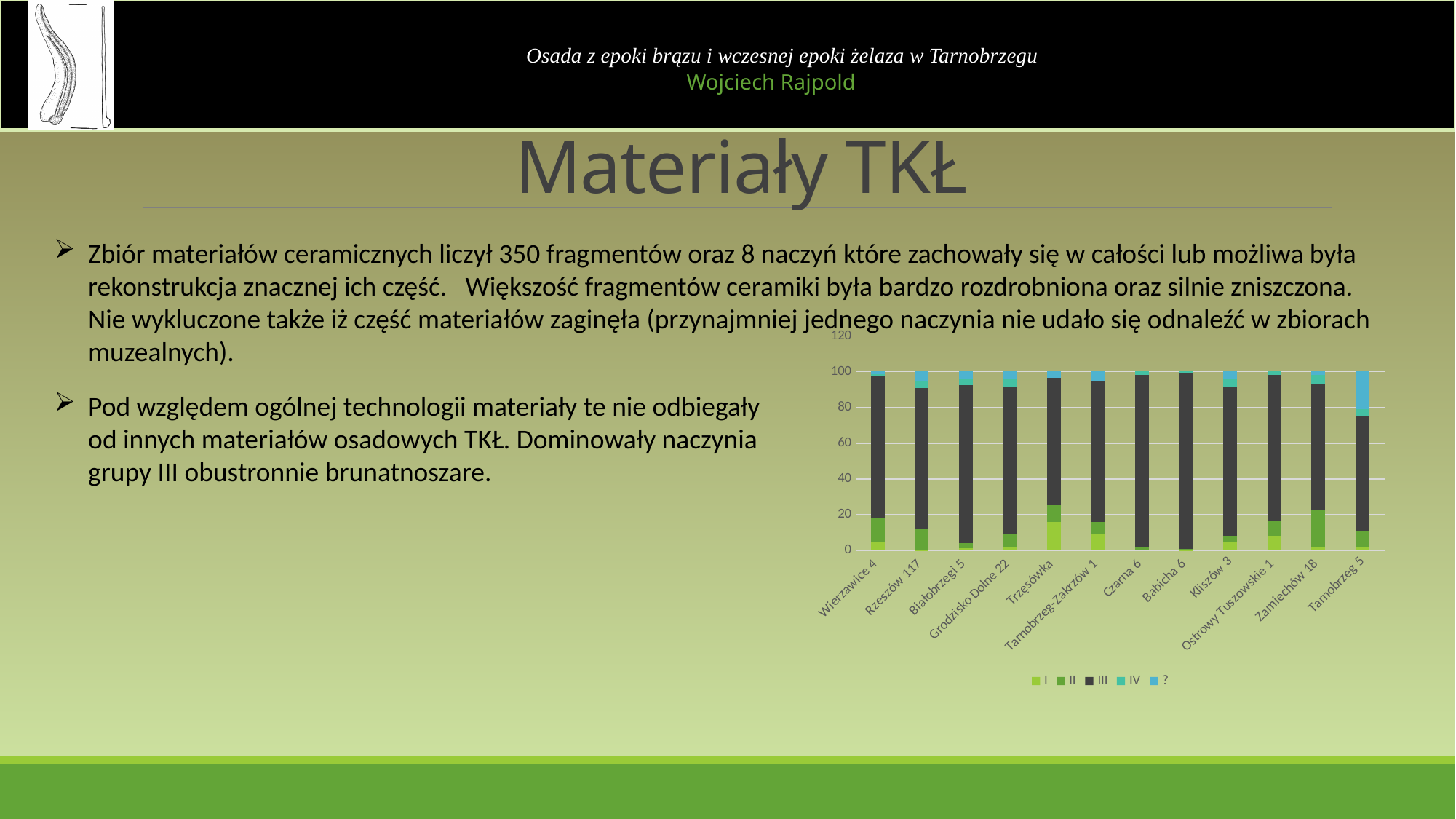
What are the entries in the chart's legend? I, II, III, IV, ? Is the '?' segment larger for Tarnobrzeg 5 or for Rzeszów 117? Tarnobrzeg 5 What is the highest tick value shown on the chart's vertical axis? 120 Which series forms the largest segment in every bar of the chart? III What kind of chart is shown on the slide? stacked bar chart How many series does the chart's legend list? 5 How many categories (sites) are shown along the x axis of the chart? 12 In the Tarnobrzeg 5 bar, does the top of the III segment lie above or below 80 on the axis? below Is the series I segment larger for Trzęsówka or for Białobrzegi 5? Trzęsówka What is the first category on the left of the chart's x axis? Wierzawice 4 Which category has the largest series I (light green) segment in the chart? Trzęsówka Which category has the largest '?' segment in the chart? Tarnobrzeg 5